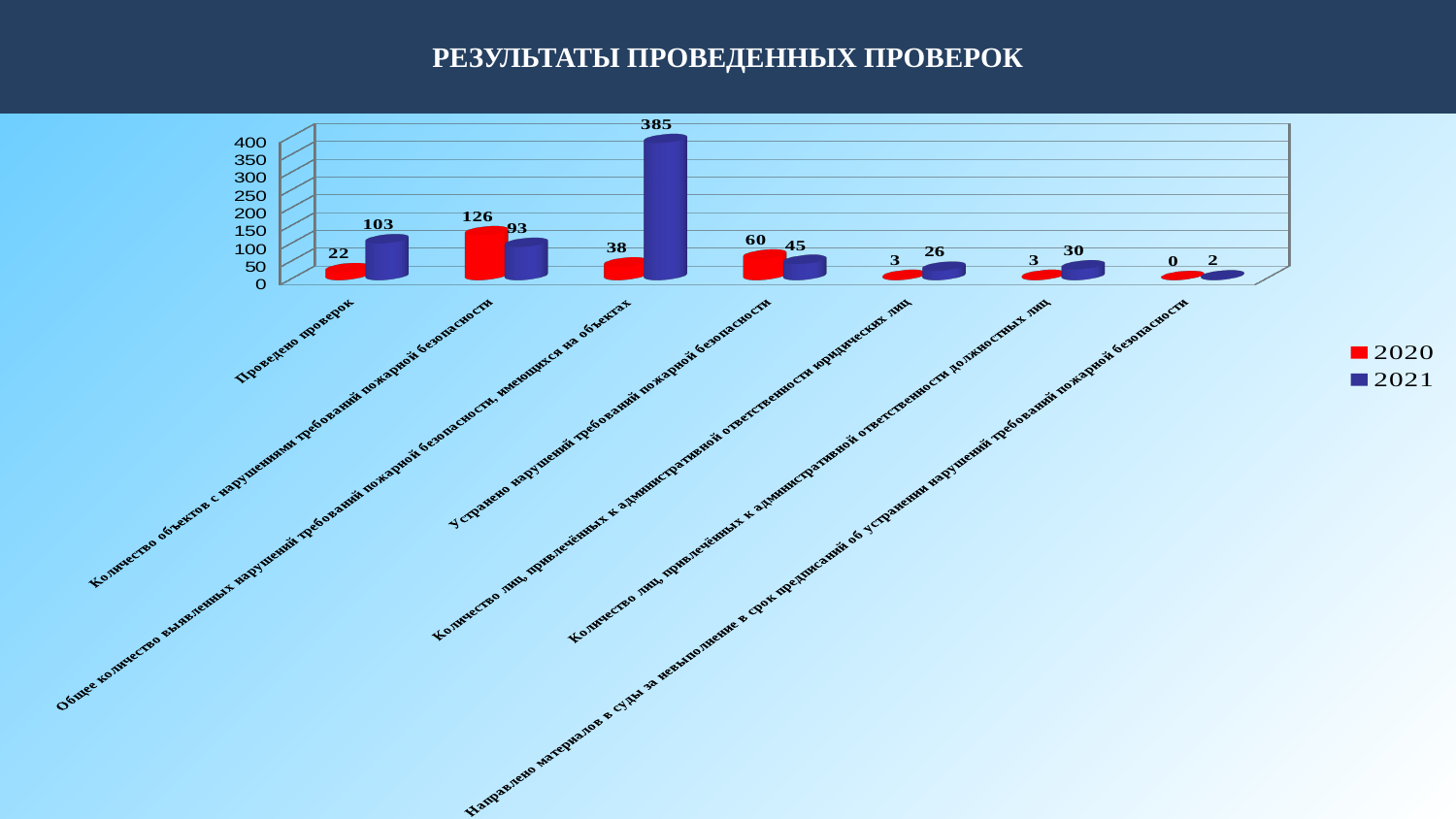
What is the 2020 value for "Количество объектов с нарушениями требований пожарной безопасности"? 126 What is the 2021 value for "Проведено проверок"? 103 What is the 2021 value for "Устранено нарушений требований пожарной безопасности"? 45 What is the title of the slide? РЕЗУЛЬТАТЫ ПРОВЕДЕННЫХ ПРОВЕРОК Which category has the highest 2021 value? Общее количество выявленных нарушений требований пожарной безопасности, имеющихся на объектах Which category has the lowest 2020 value? Направлено материалов в суды за невыполнение в срок предписаний об устранении нарушений требований пожарной безопасности How many series does the legend list? 2 For "Устранено нарушений требований пожарной безопасности", which year has the larger value, 2020 or 2021? 2020 What kind of chart is shown on the slide? Bar chart Is the 2021 value for "Общее количество выявленных нарушений требований пожарной безопасности, имеющихся на объектах" greater or less than 350? greater What is the difference between the 2021 and 2020 values for "Проведено проверок"? 81 How many categories are shown on the x axis? 7